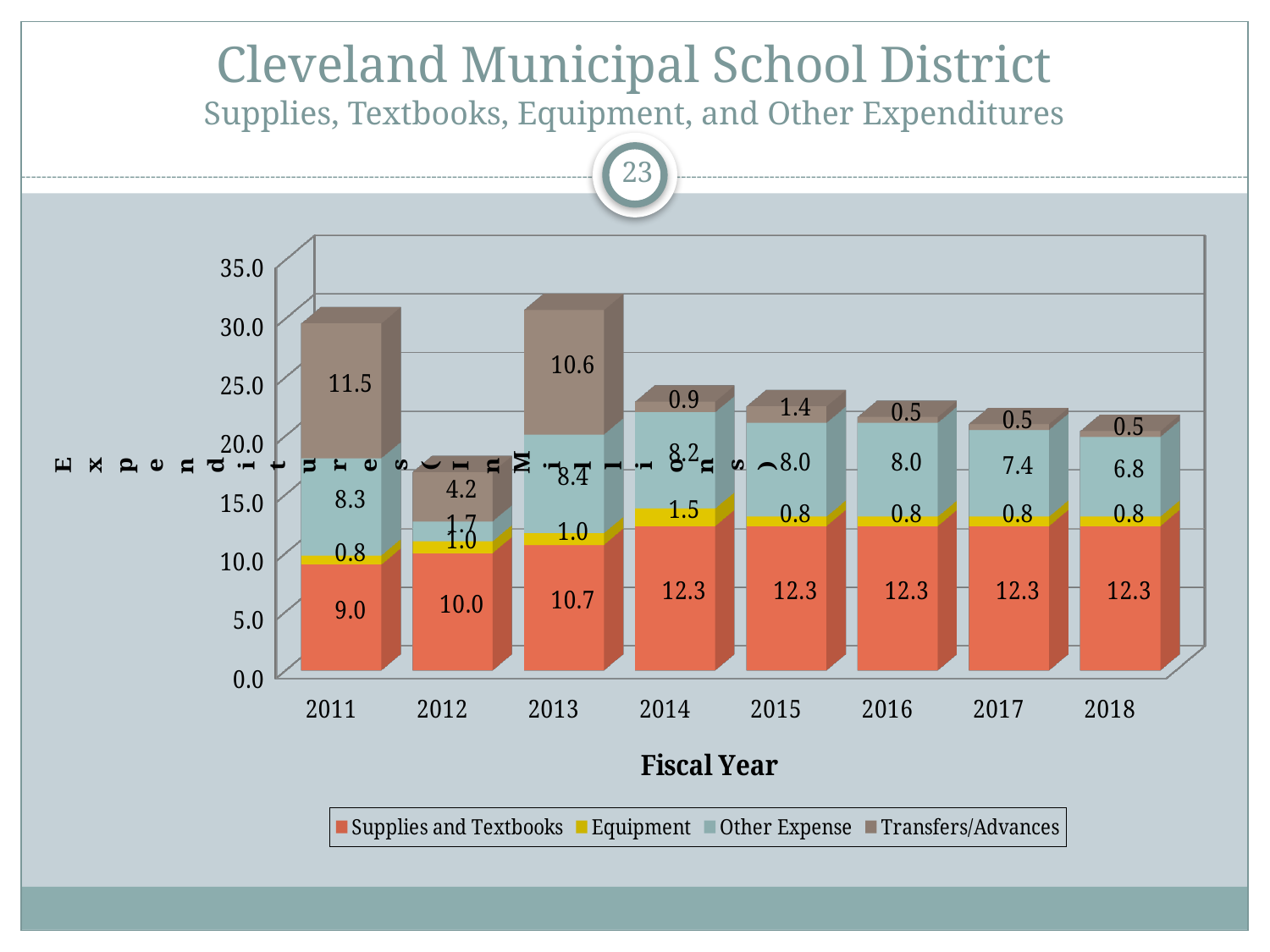
In which fiscal year is Transfers/Advances highest? 2011 What kind of chart is shown on the slide? Stacked bar chart What is the value for Other Expense in fiscal year 2018? 6.8 How many series does the legend list? 4 Which is larger: Transfers/Advances in 2011 or in 2012? 2011 What is the value for Transfers/Advances in fiscal year 2011? 11.5 What is the value for Supplies and Textbooks in fiscal year 2011? 9.0 What is the total of the stacked bar for fiscal year 2018? 20.4 What is the value for Equipment in fiscal year 2014? 1.5 In which fiscal year is Supplies and Textbooks lowest? 2011 What is the difference between Transfers/Advances in 2011 and in 2013? 0.9 How many fiscal years are shown on the x axis? 8